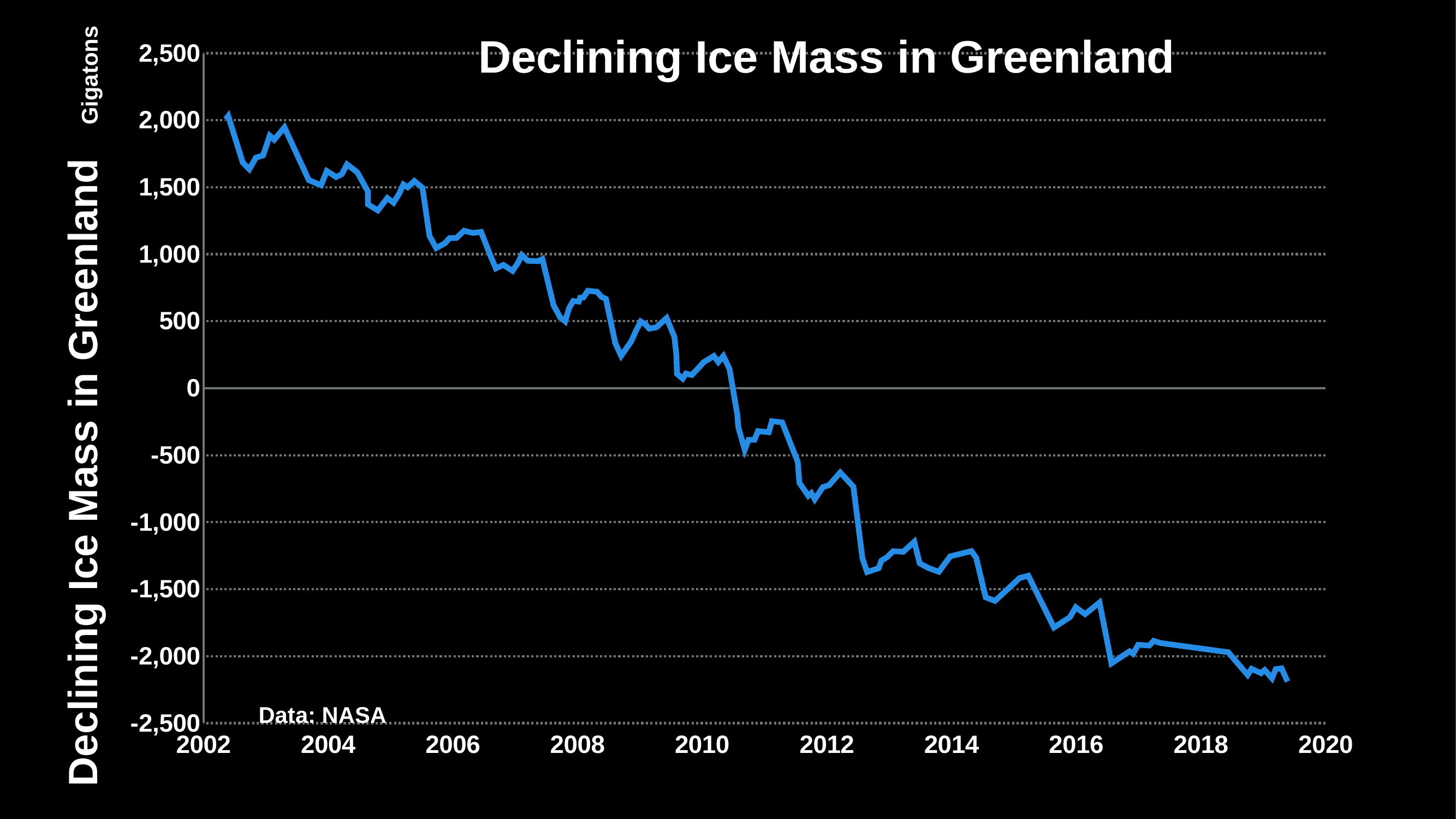
Is the value at the start of the line in 2002 greater or less than 1,500? greater Do the values rise or fall along the x axis from 2002 to 2020? fall Is the value for 2004 greater or less than 1,000? greater Is the value for 2016 greater or less than -1,500? less What is the title of the chart? Declining Ice Mass in Greenland What unit is shown on the y axis of the chart? Gigatons What kind of chart is shown on the slide? line chart